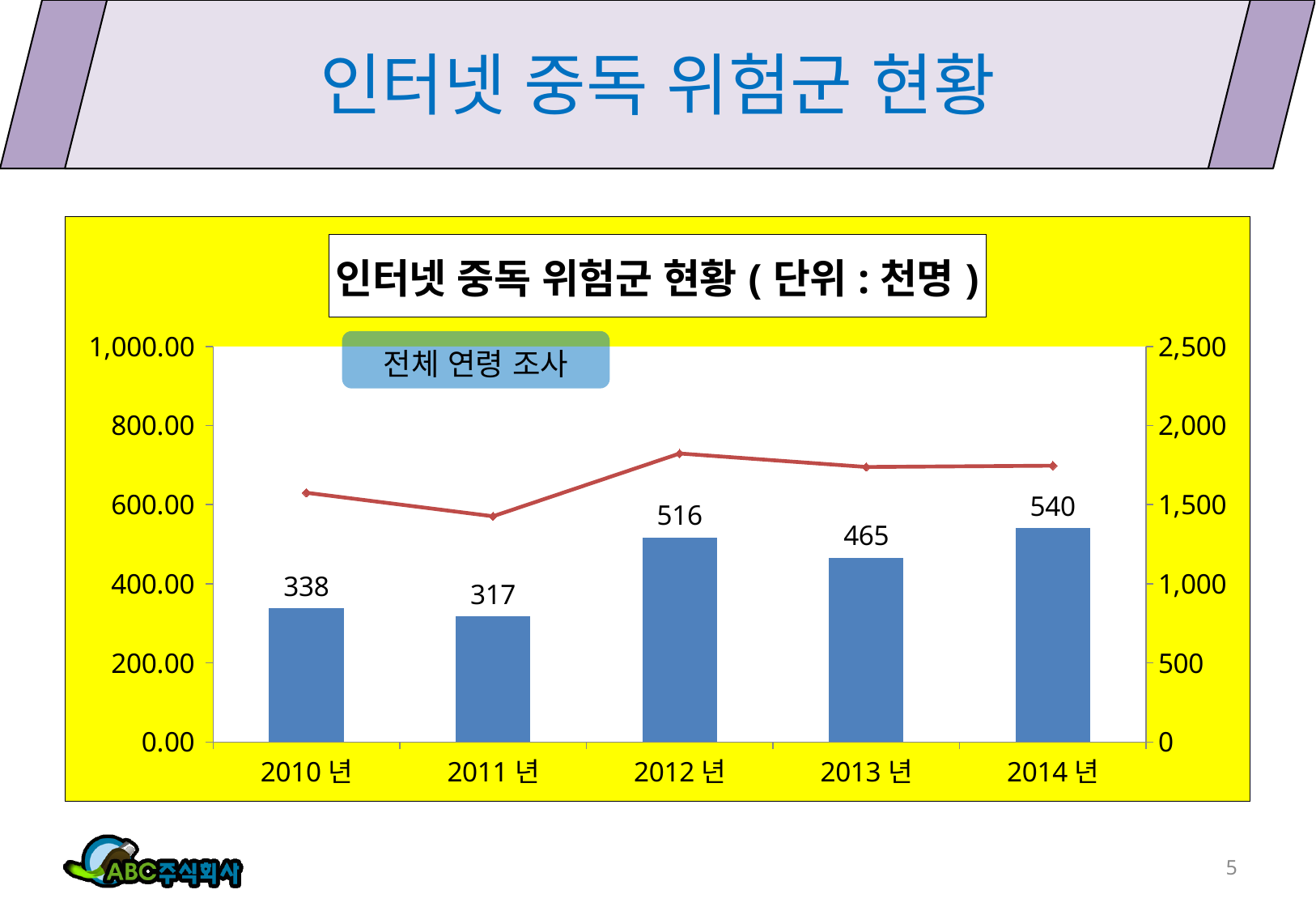
What is the difference between the bar values for 2014 년 and 2010 년? 202 What is the value of the bar for 2010 년? 338 Which year has the highest bar value? 2014 년 Which year has the lowest bar value? 2011 년 What is the title of the chart? 인터넷 중독 위험군 현황 ( 단위 : 천명 ) What is the difference between the bar values for 2012 년 and 2013 년? 51 Which is larger, the bar value for 2012 년 or for 2013 년? 2012 년 In which year does the line series reach its highest point? 2012 년 Is the value of the line series for 2012 년 on the right-hand axis greater or less than 1,500? greater What is the value of the bar for 2013 년? 465 How many years are shown on the x axis? 5 What kind of chart is shown on the slide? A bar chart combined with a line chart